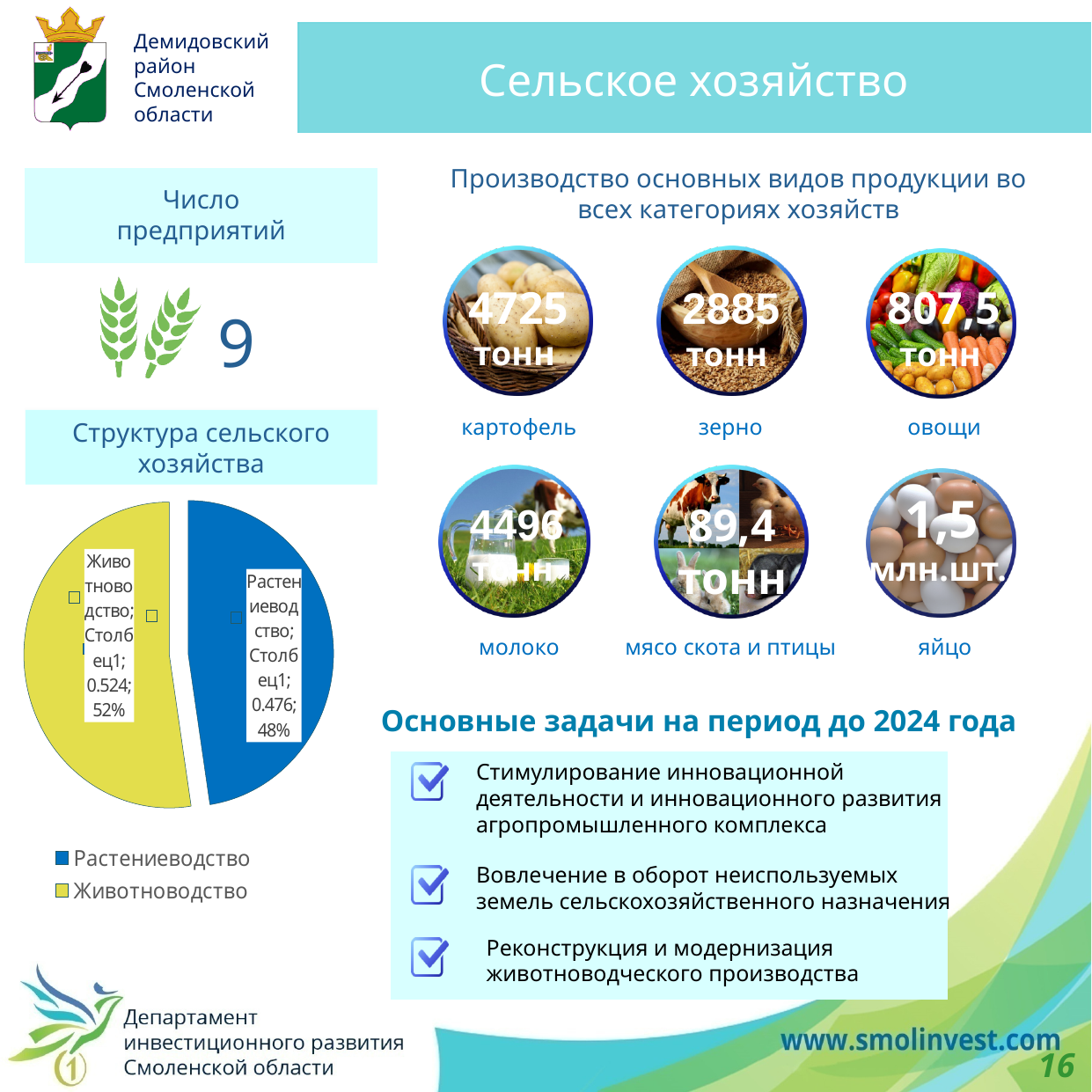
In the pie chart "Структура сельского хозяйства", what value is printed for Животноводство in the data label? 0.524 In the pie chart "Структура сельского хозяйства", what value is printed for Растениеводство in the data label? 0.476 In the pie chart "Структура сельского хозяйства", which is larger: Животноводство or Растениеводство? Животноводство In the pie chart "Структура сельского хозяйства", which slice is the smallest? Растениеводство What kind of chart is shown under the heading "Структура сельского хозяйства"? pie chart In the pie chart "Структура сельского хозяйства", what share does Животноводство have? 52% In the pie chart "Структура сельского хозяйства", what share does Растениеводство have? 48% How many slices does the pie chart "Структура сельского хозяйства" have? 2 In the pie chart "Структура сельского хозяйства", what is the difference in percentage points between Животноводство and Растениеводство? 4 percentage points How many entries does the legend of the pie chart "Структура сельского хозяйства" list? 2 In the pie chart "Структура сельского хозяйства", which slice is the largest? Животноводство In the pie chart "Структура сельского хозяйства", what colour is the Растениеводство slice? blue